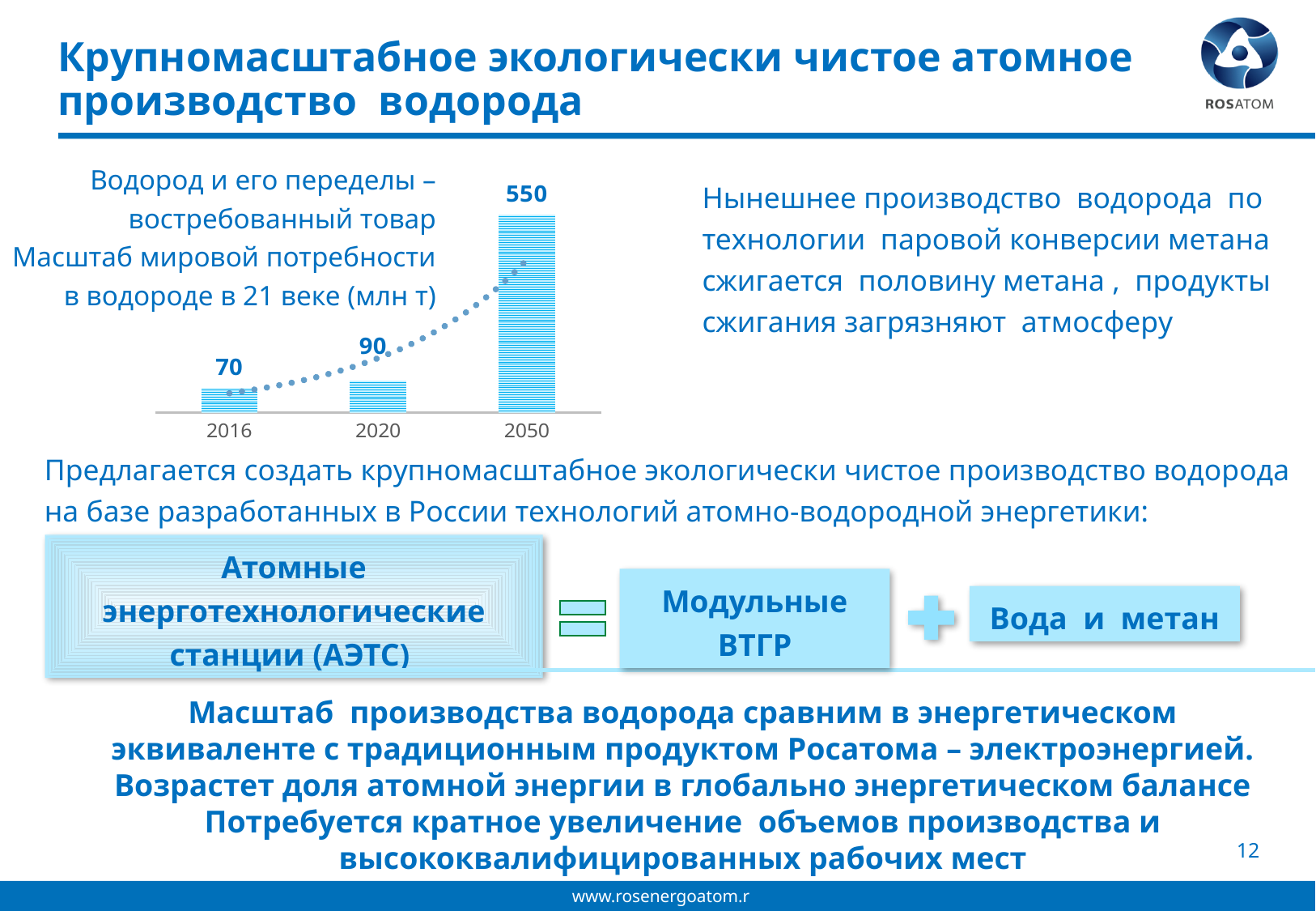
Which year has the highest value in the chart? 2050 Which year has the lowest value in the chart? 2016 What is the value for 2050 in the hydrogen demand chart? 550 What is the value for 2016 in the hydrogen demand chart? 70 What is the value for 2020 in the hydrogen demand chart? 90 What is the difference between the values for 2050 and 2020? 460 In what unit are the values in the chart expressed, according to the text next to it? млн т How many years are shown on the x axis of the chart? 3 What kind of chart is shown on the slide? bar chart Which is larger, the value for 2020 or the value for 2016? 2020 Do the values rise or fall from 2016 to 2050? rise What is the difference between the values for 2020 and 2016? 20